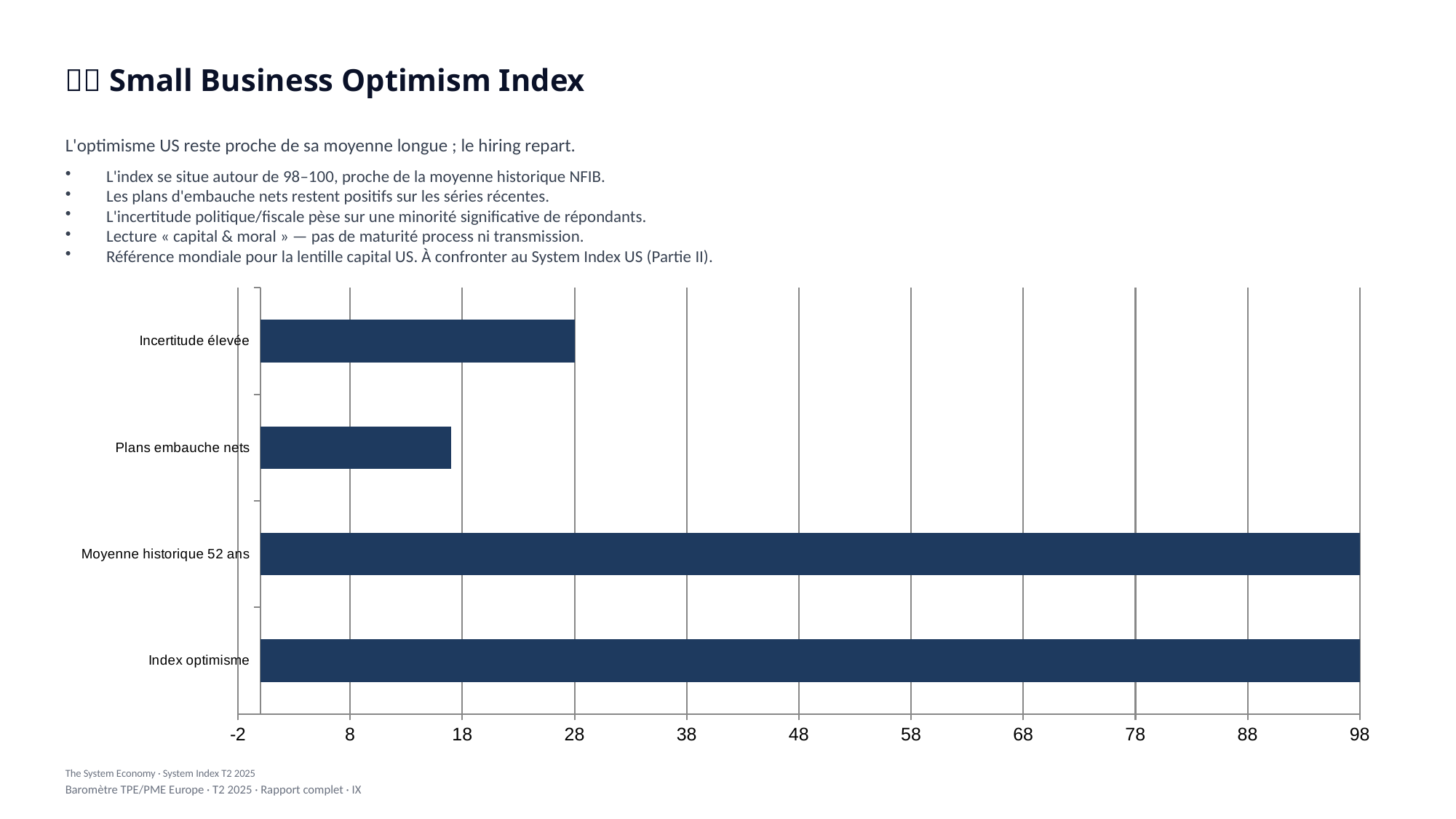
What is the title of the slide containing the chart? Small Business Optimism Index What is the value for Incertitude élevée? 28 What kind of chart is shown on the slide? bar chart What is the value for Moyenne historique 52 ans? 98 What is the difference between the value for Index optimisme and the value for Incertitude élevée? 70 Which is larger, the value for Incertitude élevée or the value for Plans embauche nets? Incertitude élevée Which category has the lowest value? Plans embauche nets Is the value for Incertitude élevée greater or less than 38? less Is the value for Plans embauche nets greater or less than 8? greater What is the value for Index optimisme? 98 How many categories are plotted in the chart? 4 Is the value for Moyenne historique 52 ans greater or less than 88? greater